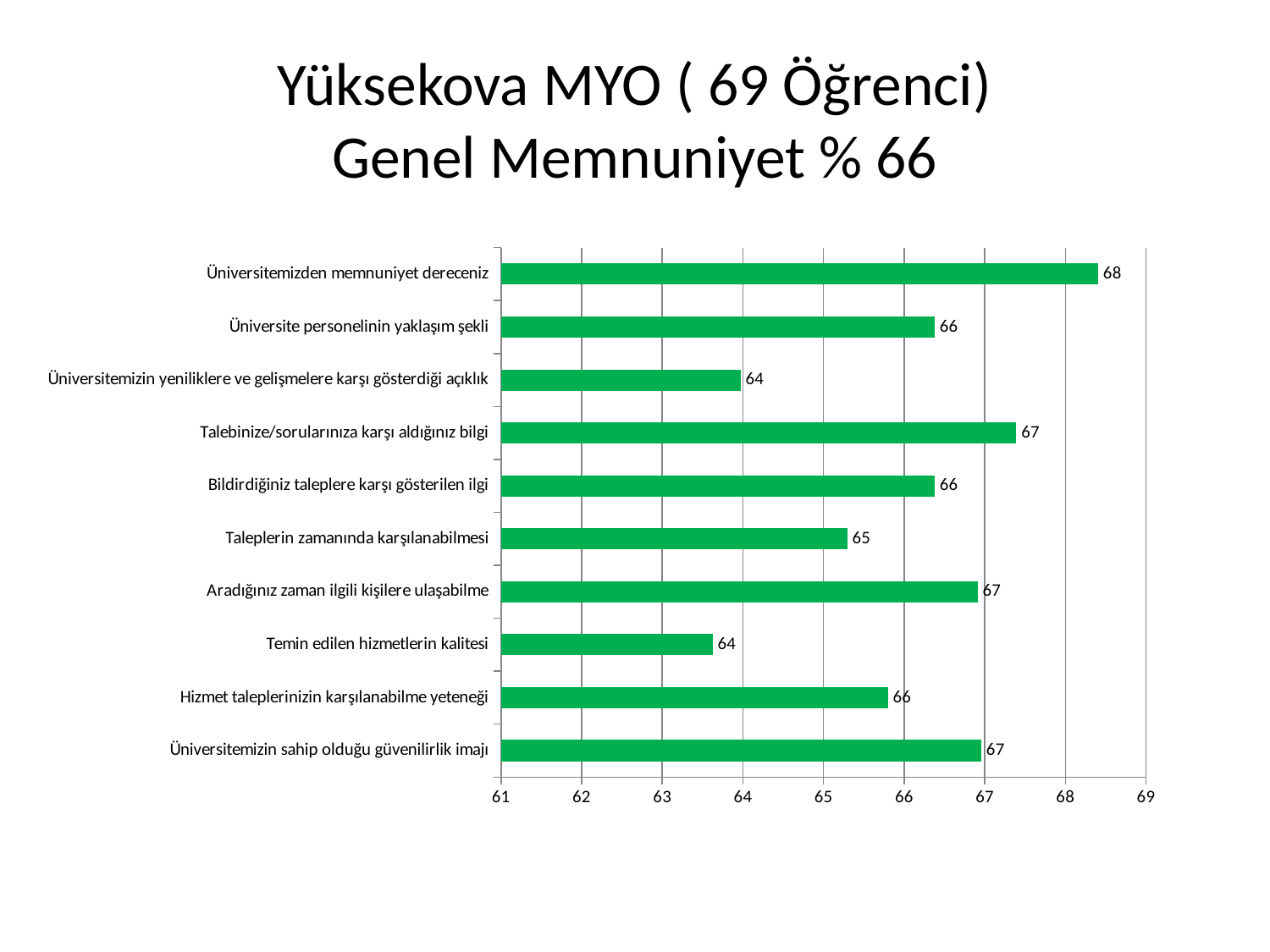
Which is larger: the value for "Üniversitemizden memnuniyet dereceniz" or the value for "Taleplerin zamanında karşılanabilmesi"? Üniversitemizden memnuniyet dereceniz What is the difference between the values for "Üniversitemizden memnuniyet dereceniz" and "Temin edilen hizmetlerin kalitesi"? 4 How many categories are shown in the chart? 10 Which category has the highest value? Üniversitemizden memnuniyet dereceniz Is the value for "Taleplerin zamanında karşılanabilmesi" greater or less than 66? less What is the value for "Üniversitemizden memnuniyet dereceniz"? 68 What is the value for "Üniversitemizin sahip olduğu güvenilirlik imajı"? 67 What colour are the bars in the chart? green What kind of chart is shown on the slide? bar chart What is the value for "Temin edilen hizmetlerin kalitesi"? 64 What is the value for "Taleplerin zamanında karşılanabilmesi"? 65